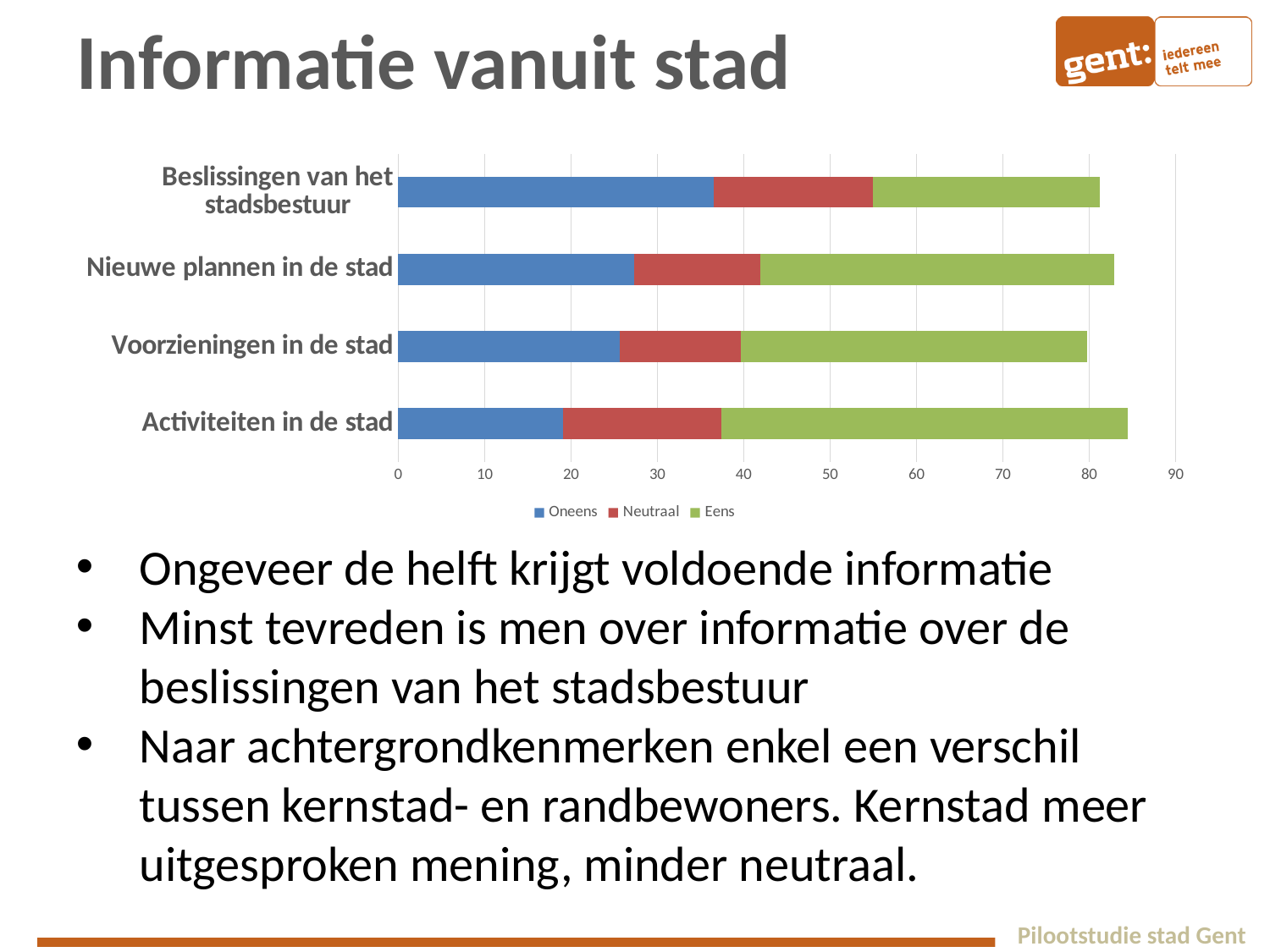
Which category has the smallest 'Oneens' segment? Activiteiten in de stad Is the 'Oneens' value for 'Activiteiten in de stad' greater or less than 30? less How many categories are plotted on the chart? 4 Is the 'Eens' segment larger for 'Activiteiten in de stad' or for 'Beslissingen van het stadsbestuur'? Activiteiten in de stad Is the 'Oneens' segment larger for 'Beslissingen van het stadsbestuur' or for 'Nieuwe plannen in de stad'? Beslissingen van het stadsbestuur What colour represents the 'Eens' series in the chart? green Is the 'Oneens' value for 'Beslissingen van het stadsbestuur' greater or less than 30? greater Which category has the smallest 'Eens' segment? Beslissingen van het stadsbestuur What kind of chart is shown on the slide? bar chart Which category has the largest 'Oneens' segment? Beslissingen van het stadsbestuur How many series does the chart's legend list? 3 Which series are listed in the chart's legend? Oneens, Neutraal, Eens